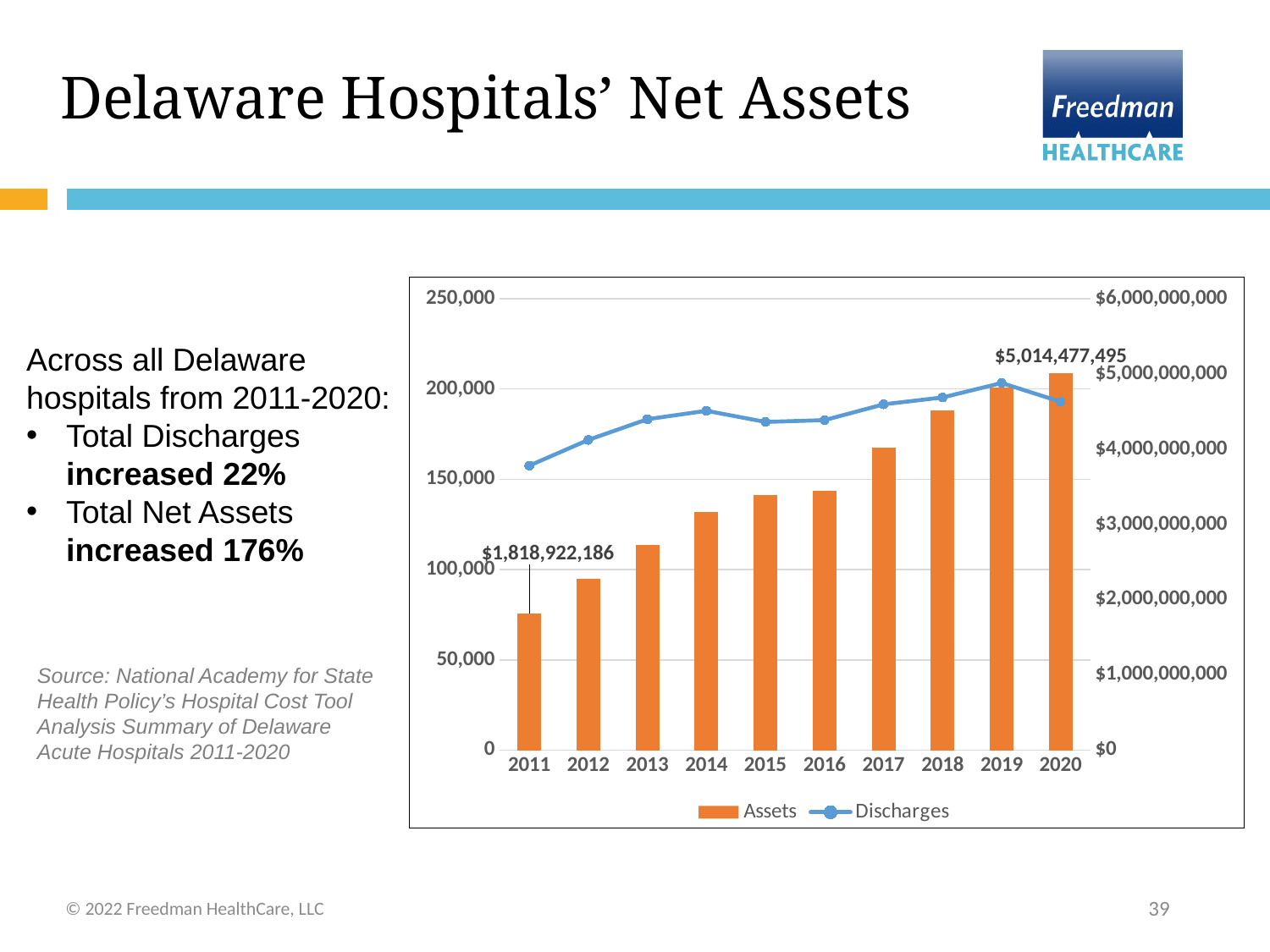
What is the value of Assets for 2011? $1,818,922,186 Which year has the highest Assets value? 2020 Which year has the lowest Assets value? 2011 How many years are shown on the x axis of the chart? 10 Is the Assets value for 2012 greater or less than $3,000,000,000? less What is the difference between the Assets value in 2020 and the Assets value in 2011? $3,195,555,309 Is the Discharges value for 2011 greater or less than 200,000? less What kind of chart is shown on the slide? A combination bar and line chart Which year has the larger Discharges value, 2019 or 2020? 2019 What is the value of Assets for 2020? $5,014,477,495 Do the Assets values rise or fall from 2011 to 2020? Rise How many series does the legend list? 2